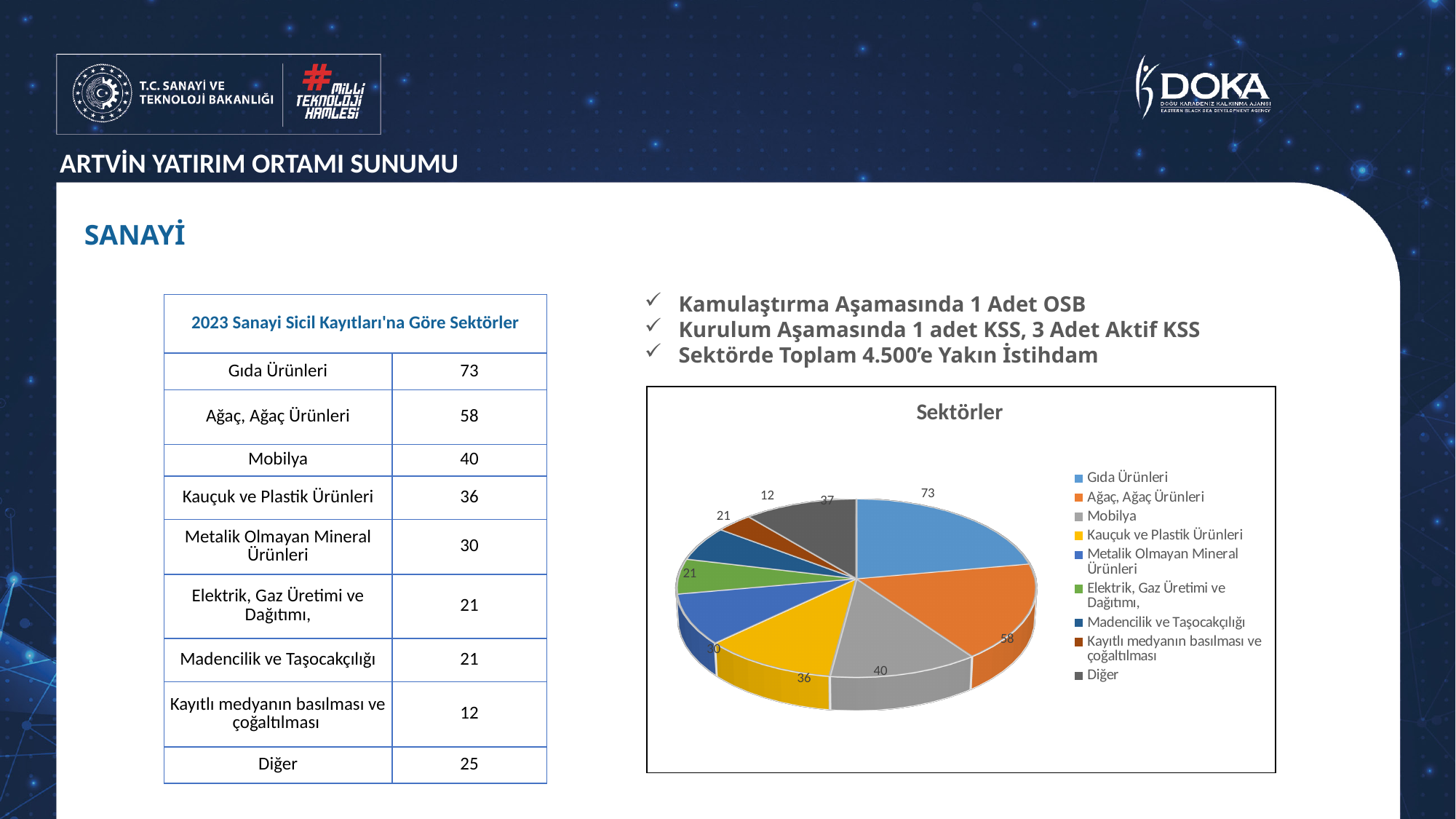
What is the title of the chart on the slide? Sektörler What kind of chart is the Sektörler chart? Pie chart In the Sektörler pie chart, what is the difference between the values for Gıda Ürünleri and Ağaç, Ağaç Ürünleri? 15 In the Sektörler pie chart, which is larger: Mobilya or Kauçuk ve Plastik Ürünleri? Mobilya In the Sektörler pie chart, what is the value for Kauçuk ve Plastik Ürünleri? 36 In the Sektörler pie chart, what is the value for Ağaç, Ağaç Ürünleri? 58 In the Sektörler pie chart, what is the value for Gıda Ürünleri? 73 In the Sektörler pie chart, what is the value for Mobilya? 40 How many sectors does the legend of the Sektörler pie chart list? 9 In the Sektörler pie chart, which sector has the largest slice? Gıda Ürünleri In the Sektörler pie chart, what is the value for Metalik Olmayan Mineral Ürünleri? 30 In the Sektörler pie chart, which sector has the smallest slice? Kayıtlı medyanın basılması ve çoğaltılması